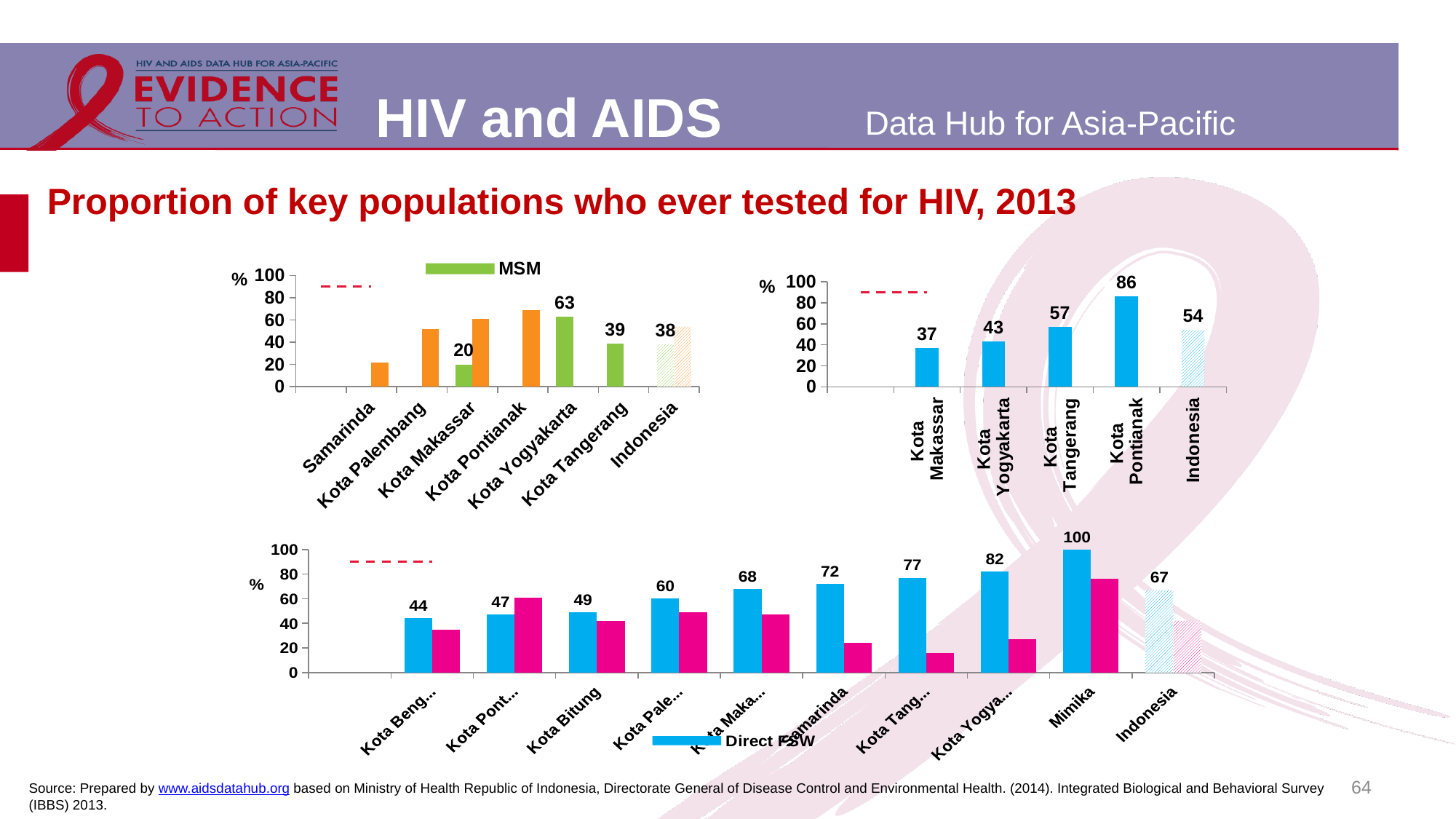
In the Direct FSW chart (bottom), what is the Direct FSW value for Samarinda? 72 In the top-right chart, what is the difference between the values for Kota Tangerang and Kota Yogyakarta? 14 In the MSM chart (top-left), what is the MSM value for Kota Makassar? 20 In the Direct FSW chart (bottom), what is the Direct FSW value for Mimika? 100 How many categories are shown in the top-right chart? 5 In the top-right chart, what is the value for Kota Pontianak? 86 In the MSM chart (top-left), which is larger, the MSM value for Kota Yogyakarta or for Kota Tangerang? Kota Yogyakarta In the top-right chart, which category has the lowest value? Kota Makassar In the top-right chart, which category has the highest value? Kota Pontianak In the MSM chart (top-left), what is the MSM value for Kota Yogyakarta? 63 In the Direct FSW chart (bottom), what is the difference between the Direct FSW values for Mimika and Indonesia? 33 What kind of chart is the Direct FSW chart at the bottom of the slide? Bar chart